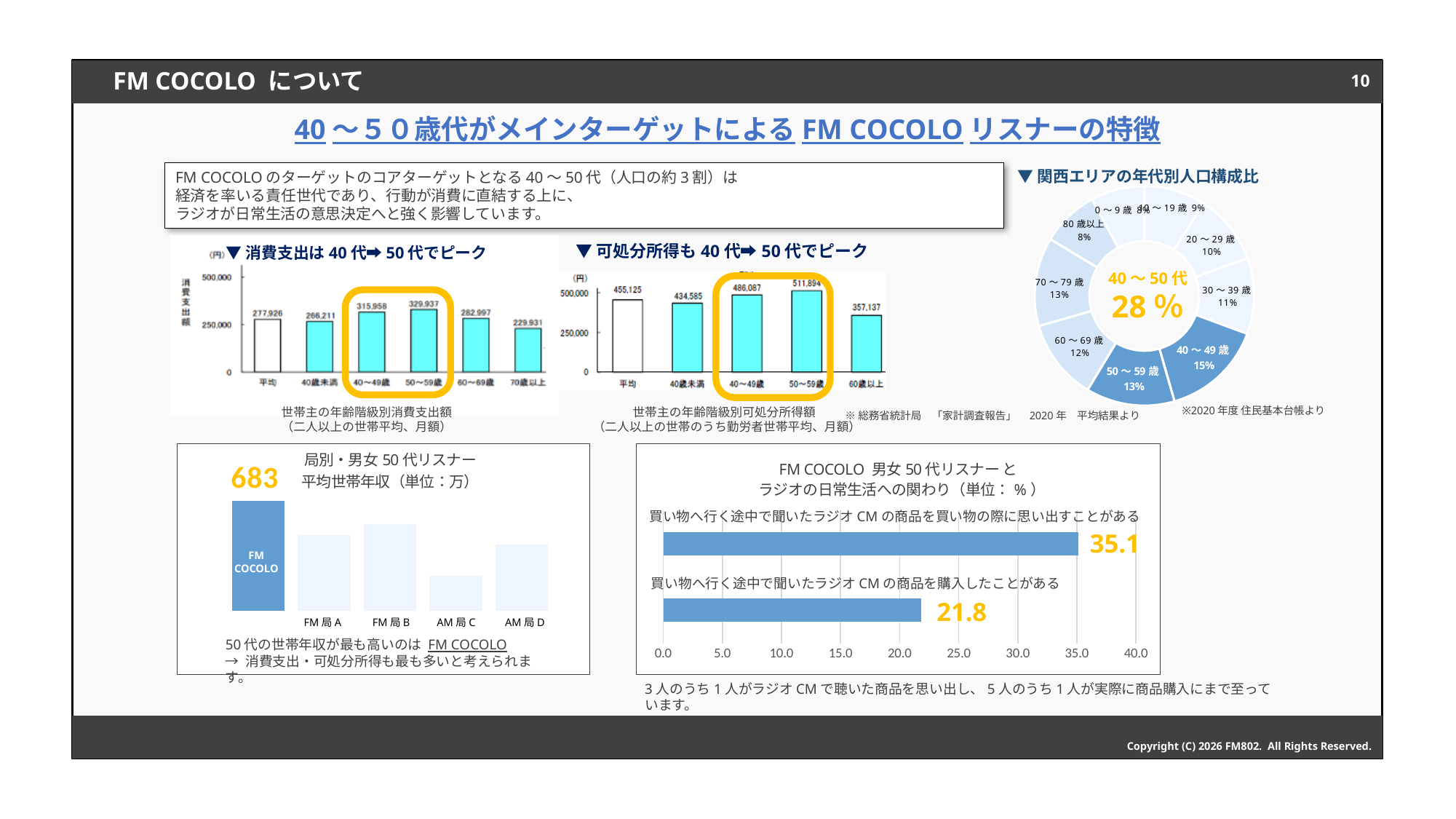
In the FM COCOLO 男女50代リスナーとラジオの日常生活への関わり chart (bottom right), what is the value for 買い物へ行く途中で聞いたラジオCMの商品を購入したことがある? 21.8 In the 関西エリアの年代別人口構成比 donut chart, what share does 40～49歳 have? 15% In the 局別・男女50代リスナー平均世帯年収 chart (bottom left), which station has the lowest bar? AM局C In the 消費支出 chart (top left), what is the value for 50～59歳? 329,937 In the 消費支出 chart (top left), what is the difference between 50～59歳 and 40～49歳? 13,979 In the 消費支出 chart (top left), which age category has the lowest value? 70歳以上 In the 関西エリアの年代別人口構成比 donut chart, which is larger, 60～69歳 or 30～39歳? 60～69歳 In the 可処分所得 chart (top middle), what is the value for 40～49歳? 486,087 In the 関西エリアの年代別人口構成比 donut chart, what percentage is shown in the centre for 40～50代? 28％ In the 局別・男女50代リスナー平均世帯年収 chart (bottom left), what is the value for FM COCOLO? 683 In the 可処分所得 chart (top middle), how many bars are plotted? 5 In the 可処分所得 chart (top middle), which age category has the highest value? 50～59歳